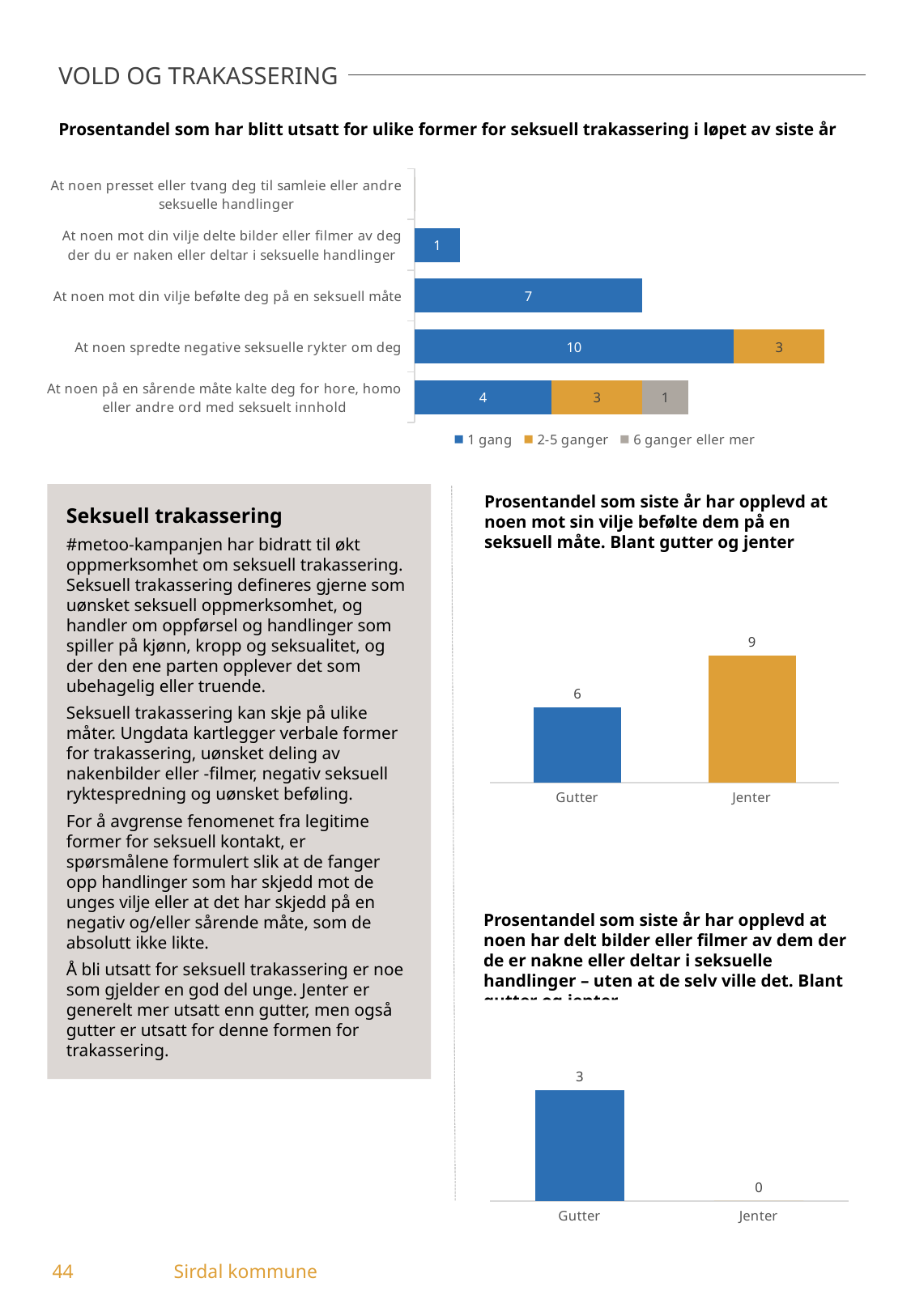
In the chart titled 'Prosentandel som siste år har opplevd at noen mot sin vilje befølte dem på en seksuell måte', what is the value for Jenter? 9 In the top chart, what kind of chart is shown? Stacked bar chart In the top chart, what is the total of the stacked bar for 'At noen spredte negative seksuelle rykter om deg'? 13 In the top chart, how many categories are listed on the vertical axis? 5 In the top chart, what is the total of the stacked bar for 'At noen på en sårende måte kalte deg for hore, homo eller andre ord med seksuelt innhold'? 8 In the top chart, how many series does the legend list? 3 In the top chart, what is the value of '2-5 ganger' for 'At noen på en sårende måte kalte deg for hore, homo eller andre ord med seksuelt innhold'? 3 In the chart titled 'Prosentandel som siste år har opplevd at noen mot sin vilje befølte dem på en seksuell måte', what is the difference between Jenter and Gutter? 3 In the bottom right chart about delte bilder eller filmer, what is the value for Jenter? 0 In the top chart, which series is shown in grey according to the legend? 6 ganger eller mer In the bottom right chart about delte bilder eller filmer, which group has the higher value, Gutter or Jenter? Gutter In the top chart, what is the value of '1 gang' for 'At noen spredte negative seksuelle rykter om deg'? 10